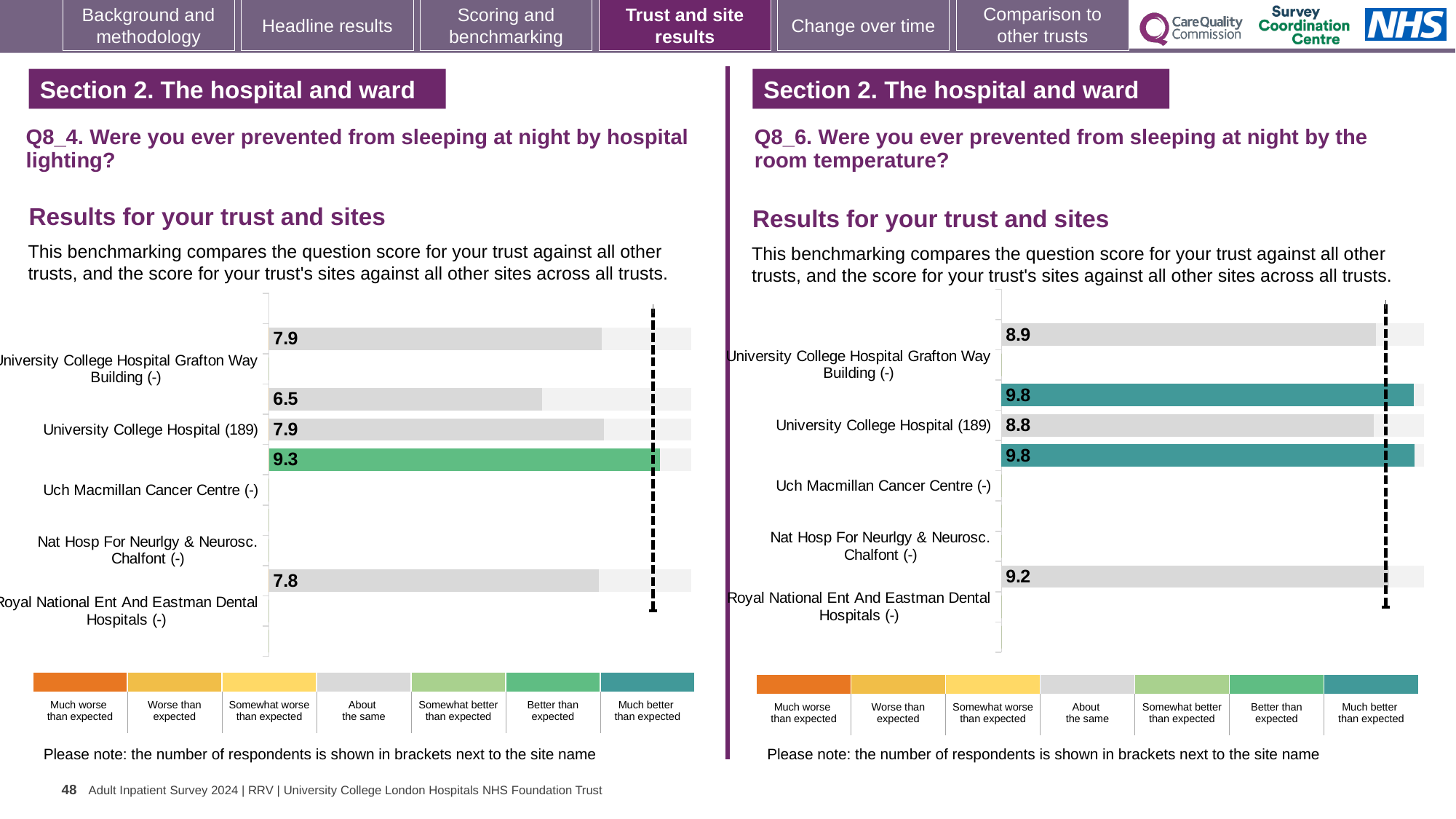
On the left chart (Q8_4, hospital lighting), what is the difference between the highest and lowest bar scores? 2.8 On the left chart (Q8_4, hospital lighting), which is larger: the bar scored 9.3 or the bar scored 7.8? 9.3 On the right chart (Q8_6, room temperature), what is the highest score shown on any bar? 9.8 How many rating categories does the colour key below each chart list? 7 On the right chart (Q8_6, room temperature), which is larger: the bar scored 9.2 or the bar scored 8.9? 9.2 On the right chart (Q8_6, room temperature), how many bars have a score label printed? 5 On the right chart (Q8_6, room temperature), what is the difference between the highest and lowest bar scores? 1.0 On the left chart (Q8_4, hospital lighting), what is the lowest score shown on any bar? 6.5 On the left chart (Q8_4, hospital lighting), what is the highest score shown on any bar? 9.3 On the left chart (Q8_4, hospital lighting), what kind of chart is used? Bar chart On the left chart (Q8_4, hospital lighting), how many bars have a score label printed? 5 On the right chart (Q8_6, room temperature), what is the lowest score shown on any bar? 8.8